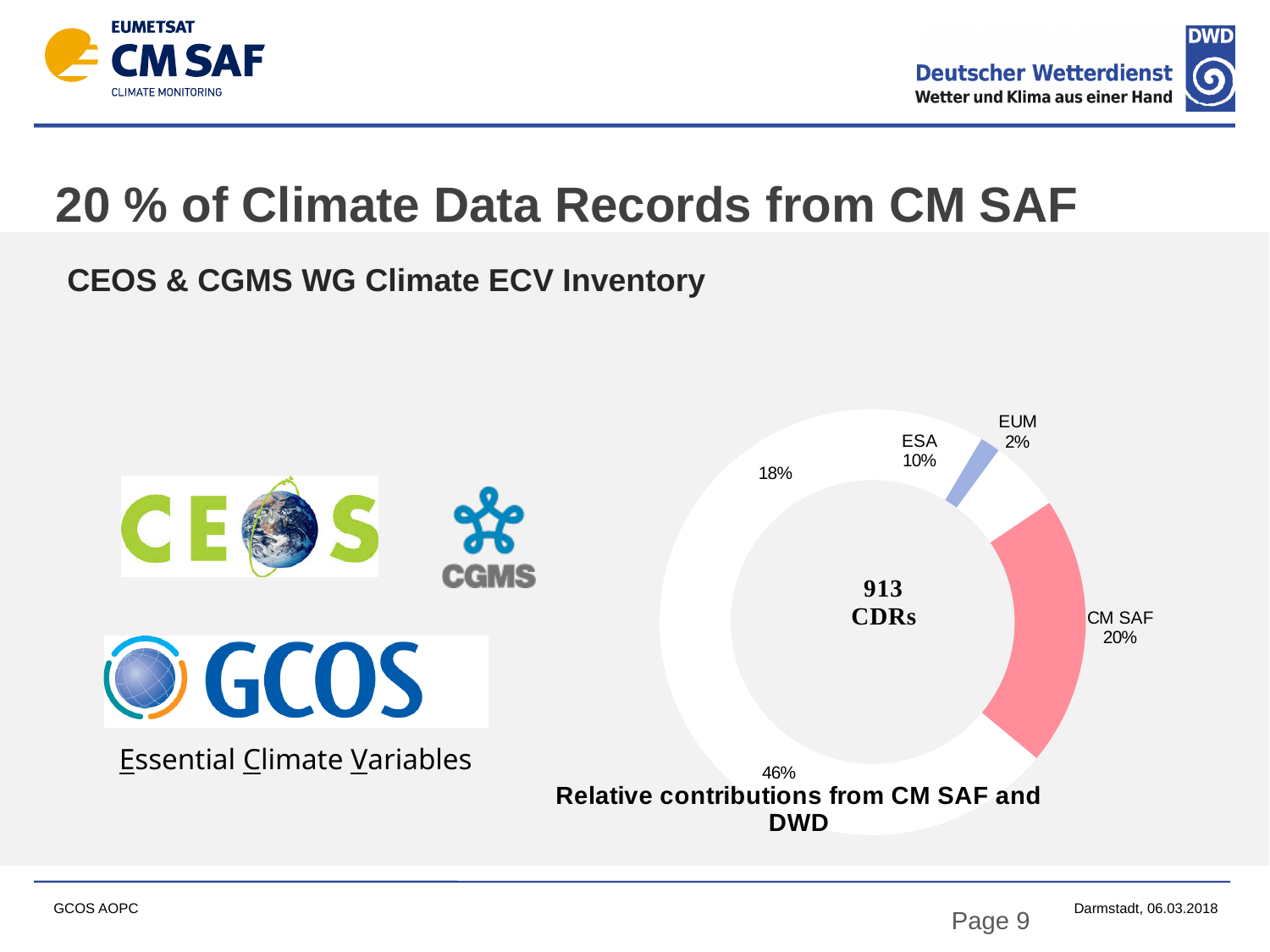
What is the largest percentage value shown on the chart? 46% What text is displayed in the centre of the doughnut chart? 913 CDRs Is the CM SAF share greater or less than 10%? greater What is the title printed below the chart? Relative contributions from CM SAF and DWD What percentage does the ESA slice represent in the chart? 10% By how many percentage points does the CM SAF share exceed the ESA share? 10 percentage points Which slice is larger, CM SAF or ESA? CM SAF Which labelled organisation has the smallest slice in the chart? EUM What percentage is shown for EUM in the chart? 2% What percentage of the doughnut chart is attributed to CM SAF? 20% What type of chart is shown on the slide? Doughnut (pie) chart